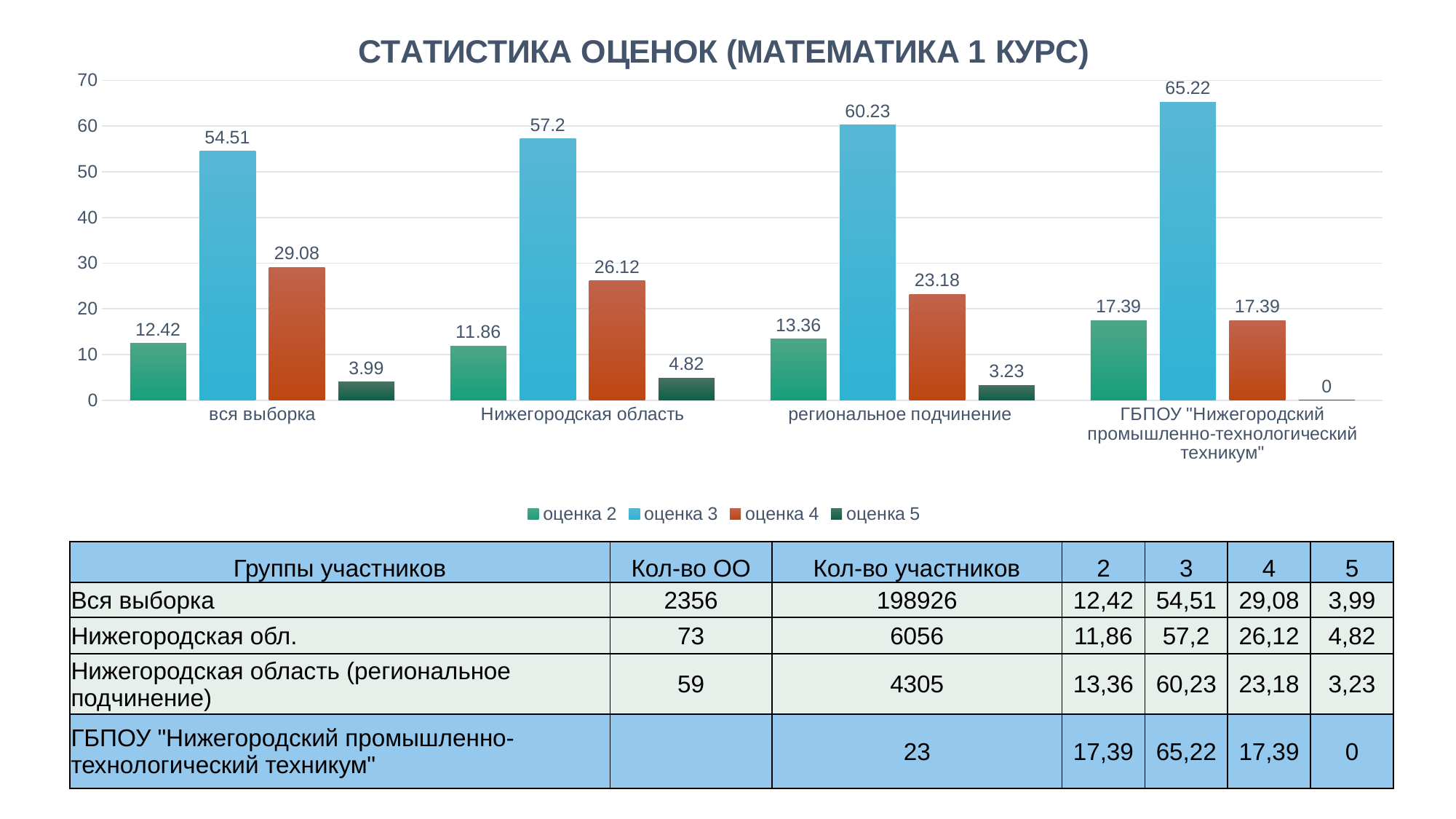
What is the value of оценка 3 for вся выборка? 54.51 Which category has the lowest value for оценка 4? ГБПОУ "Нижегородский промышленно-технологический техникум" What is the value of оценка 5 for Нижегородская область? 4.82 What is the difference between оценка 3 for ГБПОУ "Нижегородский промышленно-технологический техникум" and оценка 3 for вся выборка? 10.71 What is the value of оценка 2 for региональное подчинение? 13.36 Is the value of оценка 3 for региональное подчинение greater or less than 60? greater How many series does the legend list? 4 Which is larger: оценка 4 for вся выборка or оценка 4 for Нижегородская область? оценка 4 for вся выборка What type of chart is shown on the slide? bar chart What is the value of оценка 5 for ГБПОУ "Нижегородский промышленно-технологический техникум"? 0 How many categories are shown on the x axis? 4 Which category has the highest value for оценка 3? ГБПОУ "Нижегородский промышленно-технологический техникум"